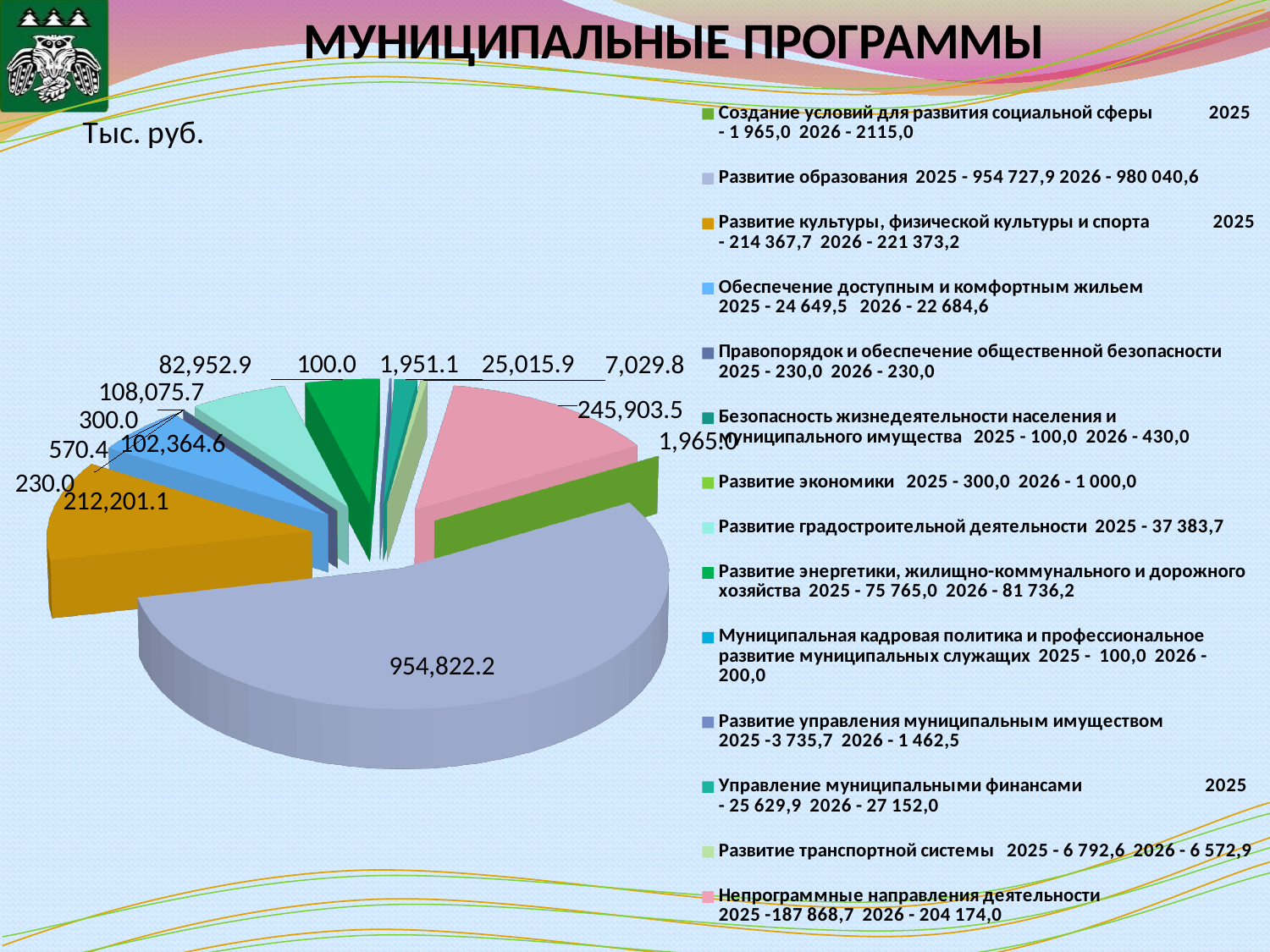
How many entries does the legend of the pie chart list? 14 According to the legend, what is the 2026 value for 'Правопорядок и обеспечение общественной безопасности'? 230,0 Which is larger on the pie chart: the gold slice labelled 212,201.1 or the pink slice labelled 245,903.5? 245,903.5 How many data labels are shown on the pie chart? 14 What kind of chart is shown on the slide? pie chart What is the difference between the slices labelled 108,075.7 and 102,364.6? 5,711.1 What is the title of the slide containing the pie chart? МУНИЦИПАЛЬНЫЕ ПРОГРАММЫ What is the smallest value labelled on the pie chart? 100.0 What is the largest value labelled on the pie chart? 954,822.2 What is the difference between the largest slice (954,822.2) and the pink slice labelled 245,903.5? 708,918.7 What unit is stated for the values on the chart? Тыс. руб. According to the legend, what is the 2025 value for 'Развитие образования'? 954 727,9